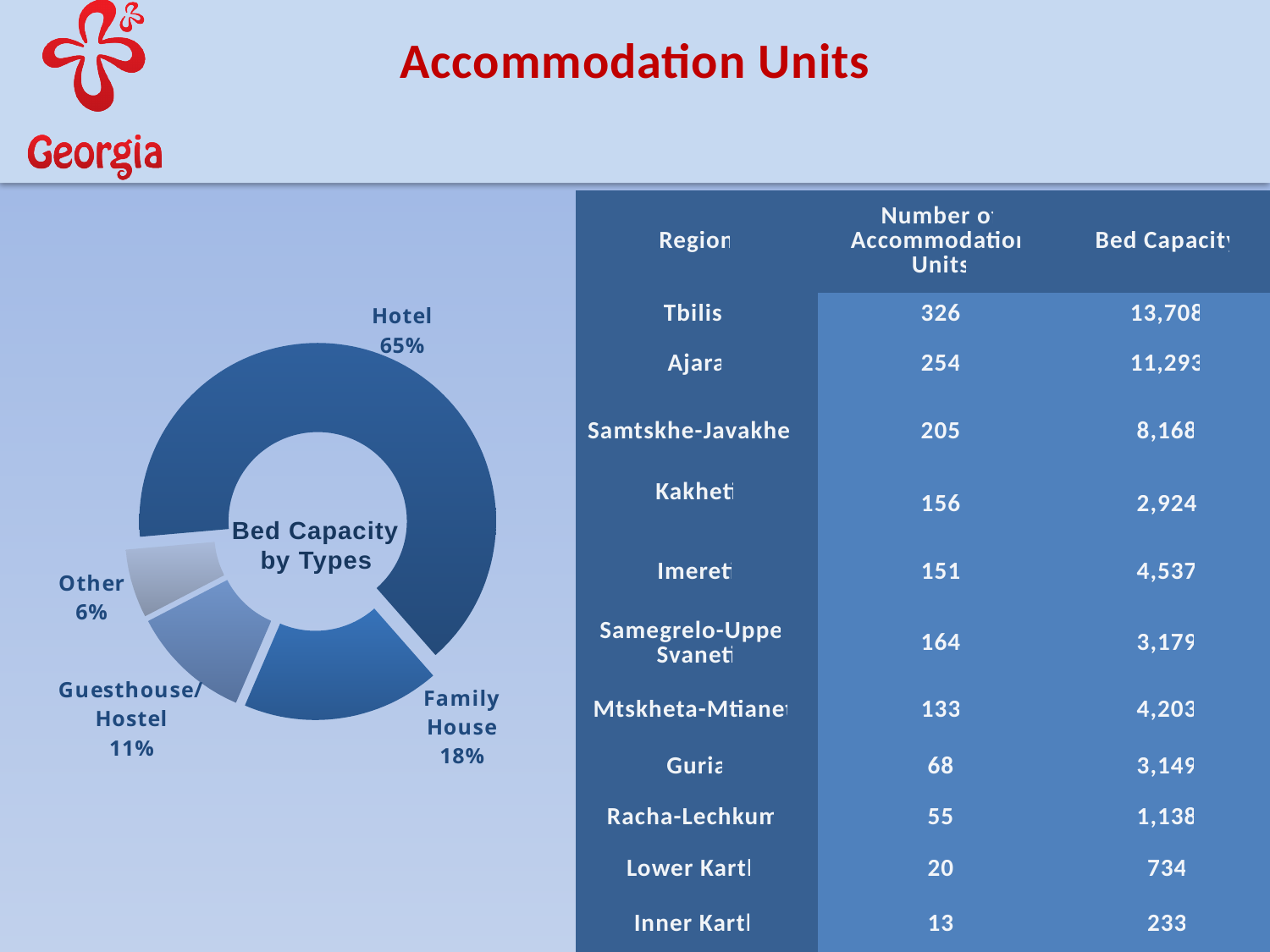
In the "Bed Capacity by Types" chart, which has the larger share: Guesthouse/Hostel or Family House? Family House How many types are shown in the "Bed Capacity by Types" chart? 4 In the "Bed Capacity by Types" chart, what share does Family House have? 18% In the "Bed Capacity by Types" chart, what share does Hotel have? 65% In the "Bed Capacity by Types" chart, what share does Other have? 6% In the "Bed Capacity by Types" chart, what share does Guesthouse/Hostel have? 11% What kind of chart is the "Bed Capacity by Types" chart? Doughnut chart Which type has the largest share in the "Bed Capacity by Types" chart? Hotel In the "Bed Capacity by Types" chart, what is the combined share of Guesthouse/Hostel and Other? 17% What is the title shown in the centre of the doughnut chart? Bed Capacity by Types Which type has the smallest share in the "Bed Capacity by Types" chart? Other In the "Bed Capacity by Types" chart, how many percentage points larger is Hotel's share than Family House's share? 47